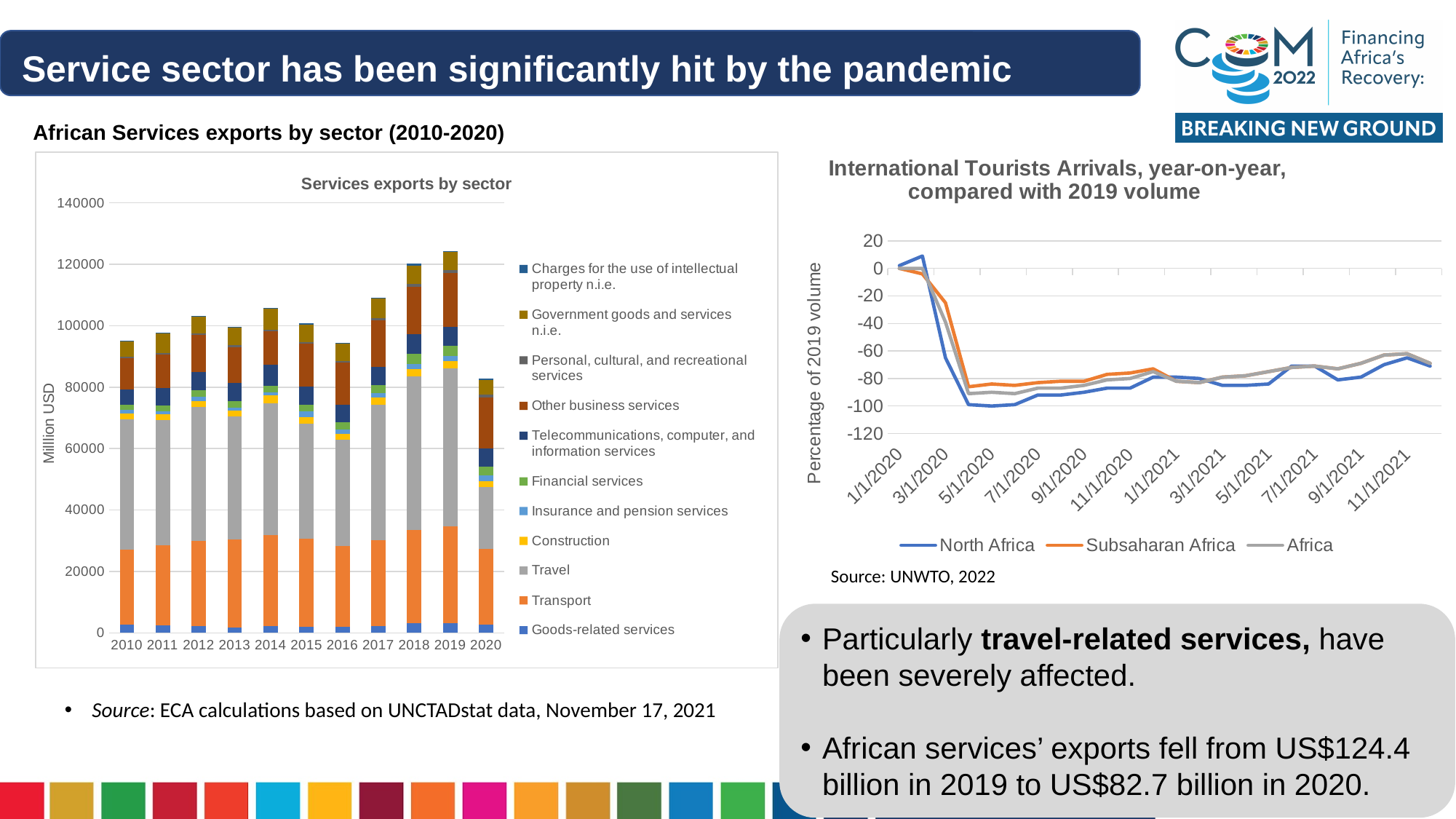
How many series does the legend of the 'Services exports by sector' chart list? 11 In the 'Services exports by sector' chart, is the total bar for 2020 greater or less than 100000? less In the 'Services exports by sector' chart, how many years are shown on the x axis? 11 What is the y-axis label of the 'International Tourists Arrivals' chart? Percentage of 2019 volume What kind of chart is the 'Services exports by sector' chart on the left? Stacked bar chart In the 'International Tourists Arrivals' chart, is the North Africa value at 5/1/2020 greater or less than -80? less In the 'Services exports by sector' chart, is the total bar for 2019 greater or less than 120000? greater In the 'Services exports by sector' chart, which year has the shortest stacked bar? 2020 What kind of chart is the 'International Tourists Arrivals' chart on the right? Line chart In the 'Services exports by sector' chart, which year has the tallest stacked bar? 2019 How many series does the legend of the 'International Tourists Arrivals' chart list? 3 In the 'International Tourists Arrivals' chart, which series is higher at 5/1/2020: North Africa or Subsaharan Africa? Subsaharan Africa